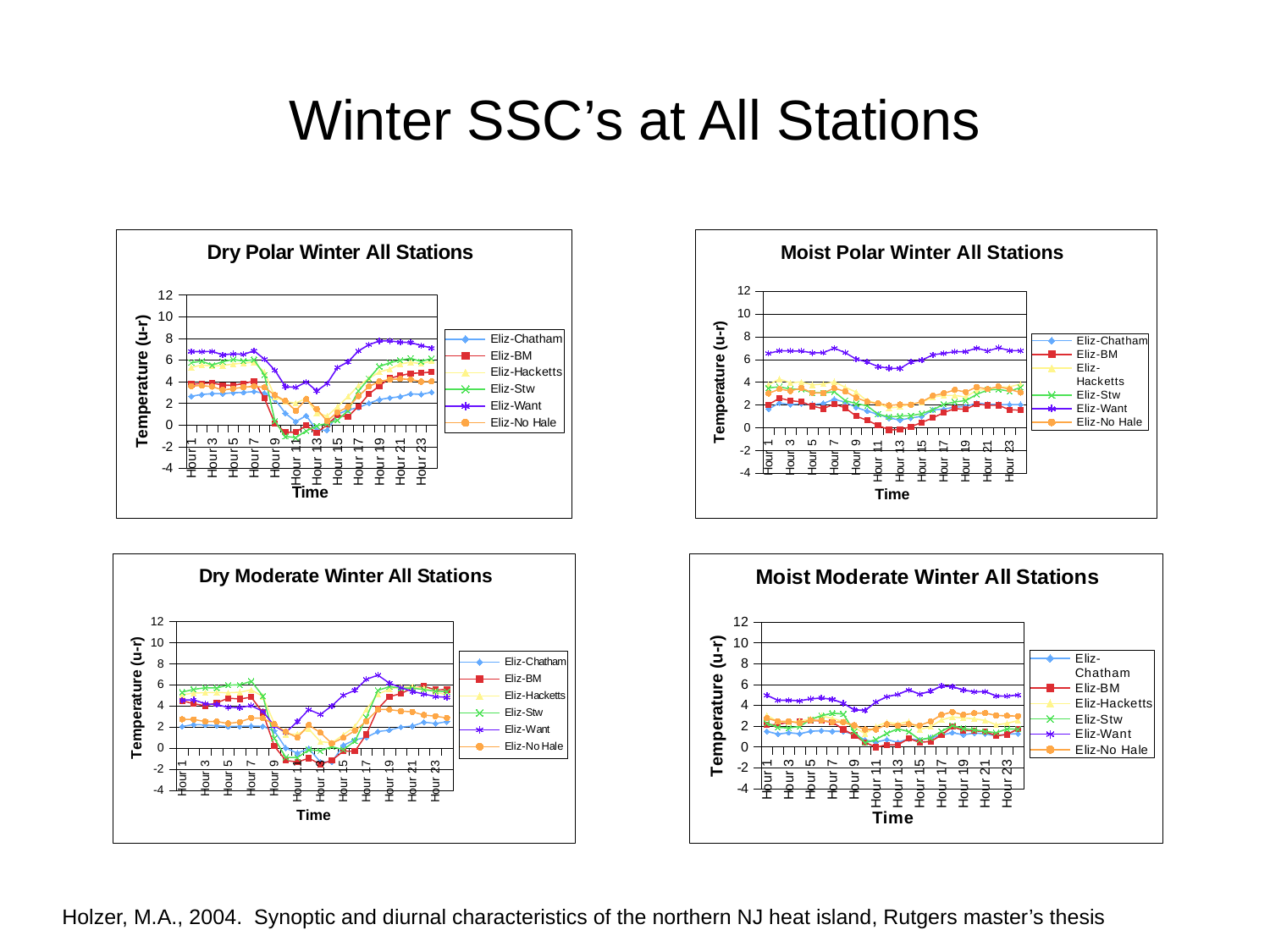
What kind of chart is 'Dry Polar Winter All Stations'? line chart In 'Moist Polar Winter All Stations', does the Eliz-Want series rise or fall from Hour 7 to Hour 13? fall How many series does the legend of 'Moist Polar Winter All Stations' list? 6 In 'Moist Moderate Winter All Stations', which series has the highest values across the day? Eliz-Want In 'Dry Polar Winter All Stations', which is larger at Hour 13: Eliz-Want or Eliz-BM? Eliz-Want In 'Dry Polar Winter All Stations', does the Eliz-BM series rise or fall from Hour 13 to Hour 21? rise In 'Dry Moderate Winter All Stations', is the value for Eliz-Want at Hour 17 greater or less than 4? greater In 'Moist Polar Winter All Stations', is the value for Eliz-BM at Hour 13 greater or less than 2? less In 'Dry Polar Winter All Stations', is the value for Eliz-Want at Hour 19 greater or less than 6? greater What is the y-axis label on the 'Dry Moderate Winter All Stations' chart? Temperature (u-r) What is the x-axis label on the 'Moist Moderate Winter All Stations' chart? Time